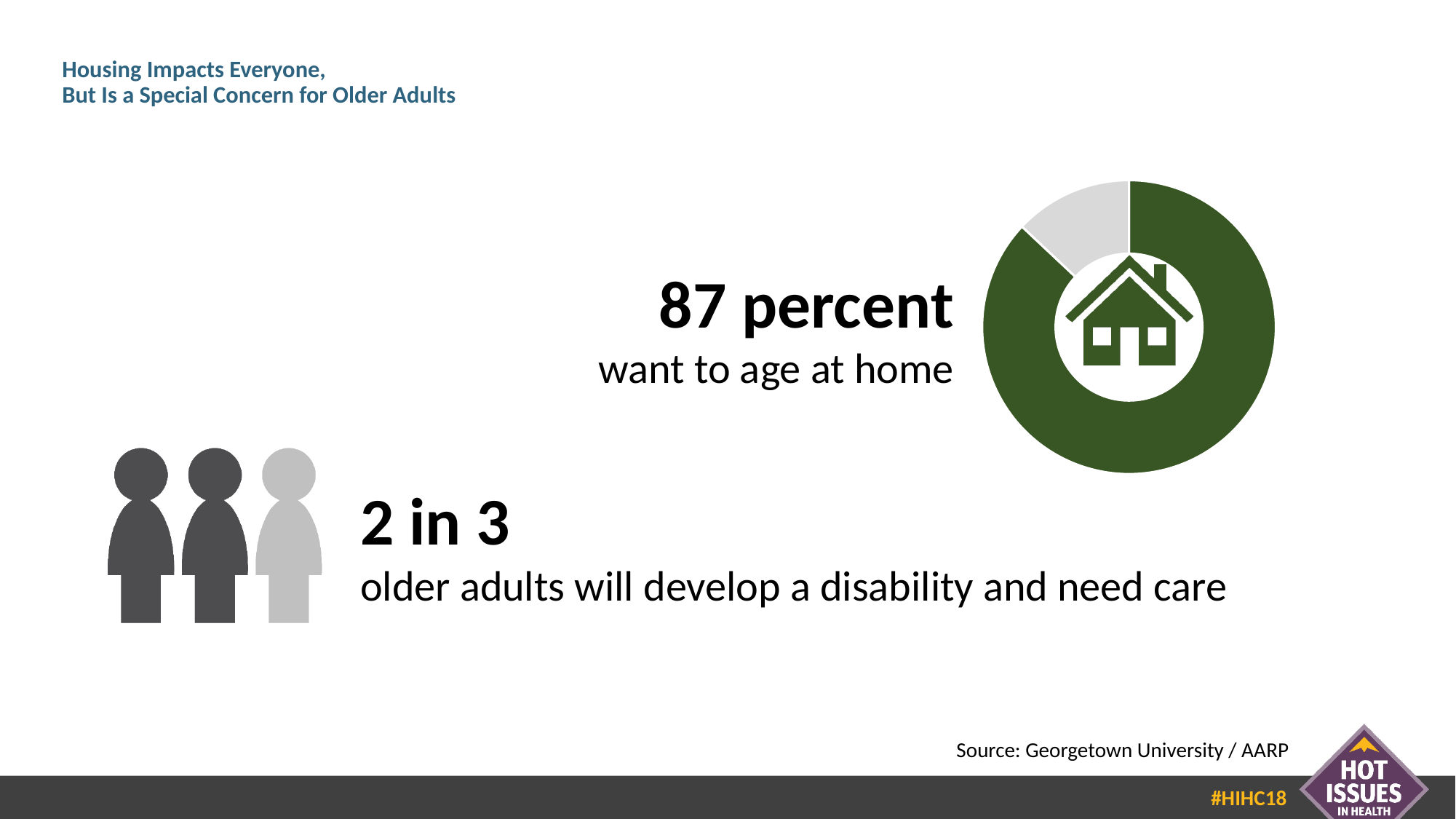
What kind of chart is shown next to the text "87 percent want to age at home"? Donut (pie) chart How many slices does the donut chart have? 2 What colour is the slice representing the 87 percent who want to age at home? Green According to the pictogram, how many older adults out of 3 will develop a disability and need care? 2 in 3 What icon is shown in the centre of the donut chart? A house In the donut chart, what share of older adults want to age at home? 87 percent In the pictogram of people, how many figures are shaded dark grey? 2 Is the green slice of the donut chart greater or less than 50 percent? greater In the pictogram of people on the left, how many person figures are shown? 3 What source is cited for the figures on the slide? Georgetown University / AARP In the donut chart, which slice is larger, the green slice or the grey slice? The green slice